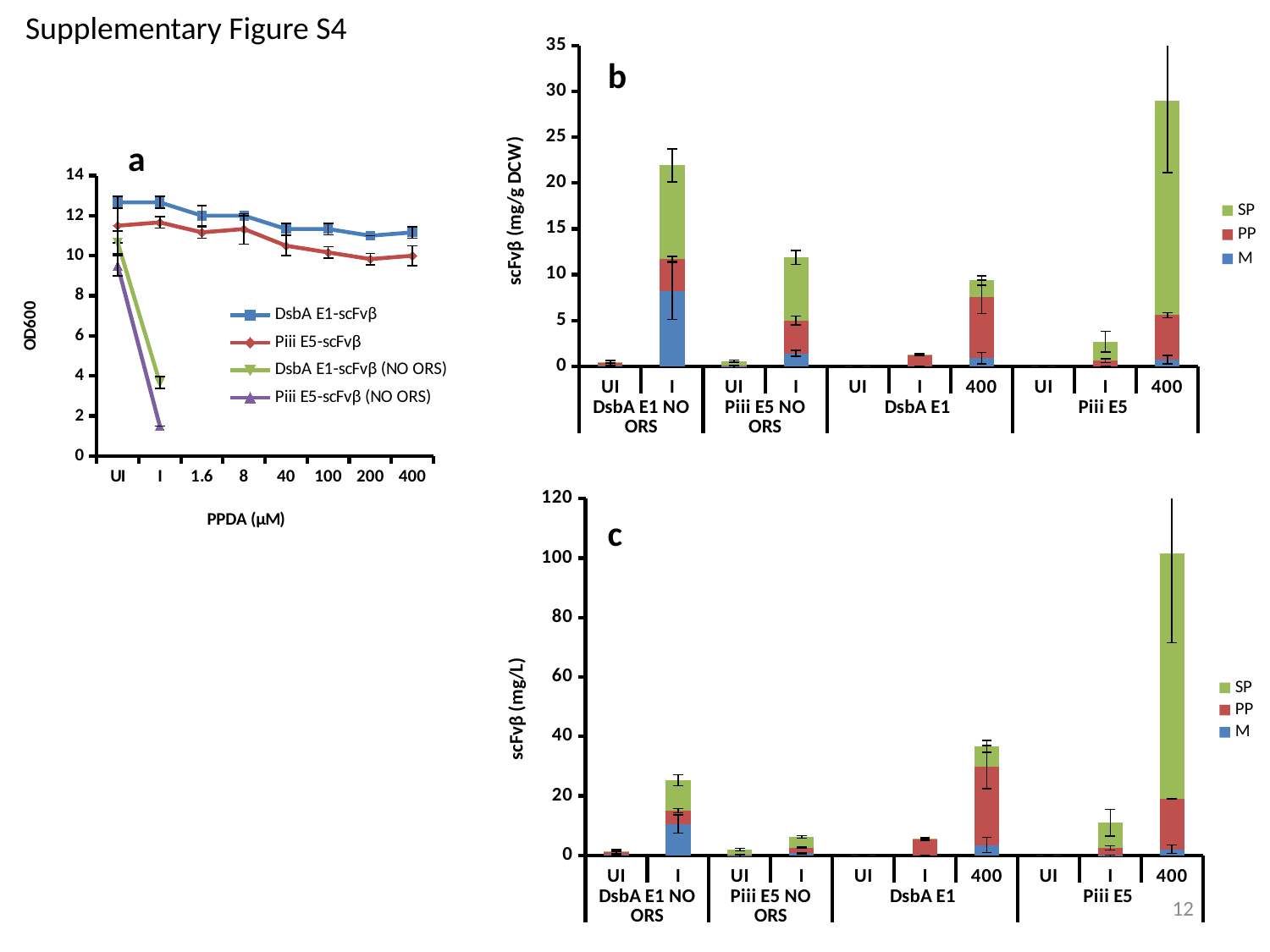
What kind of chart is chart b (scFvβ mg/g DCW)? bar chart In chart a, is the OD600 value for DsbA E1-scFvβ at UI greater or less than 12? greater In chart a, is the OD600 value for Piii E5-scFvβ (NO ORS) at I greater or less than 2? less How many series does the legend of chart a list? 4 In chart c, is the total for Piii E5 at 400 greater or less than 80? greater In chart b, which bar has the highest total? Piii E5 400 In chart a, does the DsbA E1-scFvβ series rise or fall from UI to 400? fall How many points along the x axis does chart a have? 8 How many series does the legend of chart b list? 3 What kind of chart is chart a (the OD600 chart)? line chart What is the y-axis label of chart c? scFvβ (mg/L)